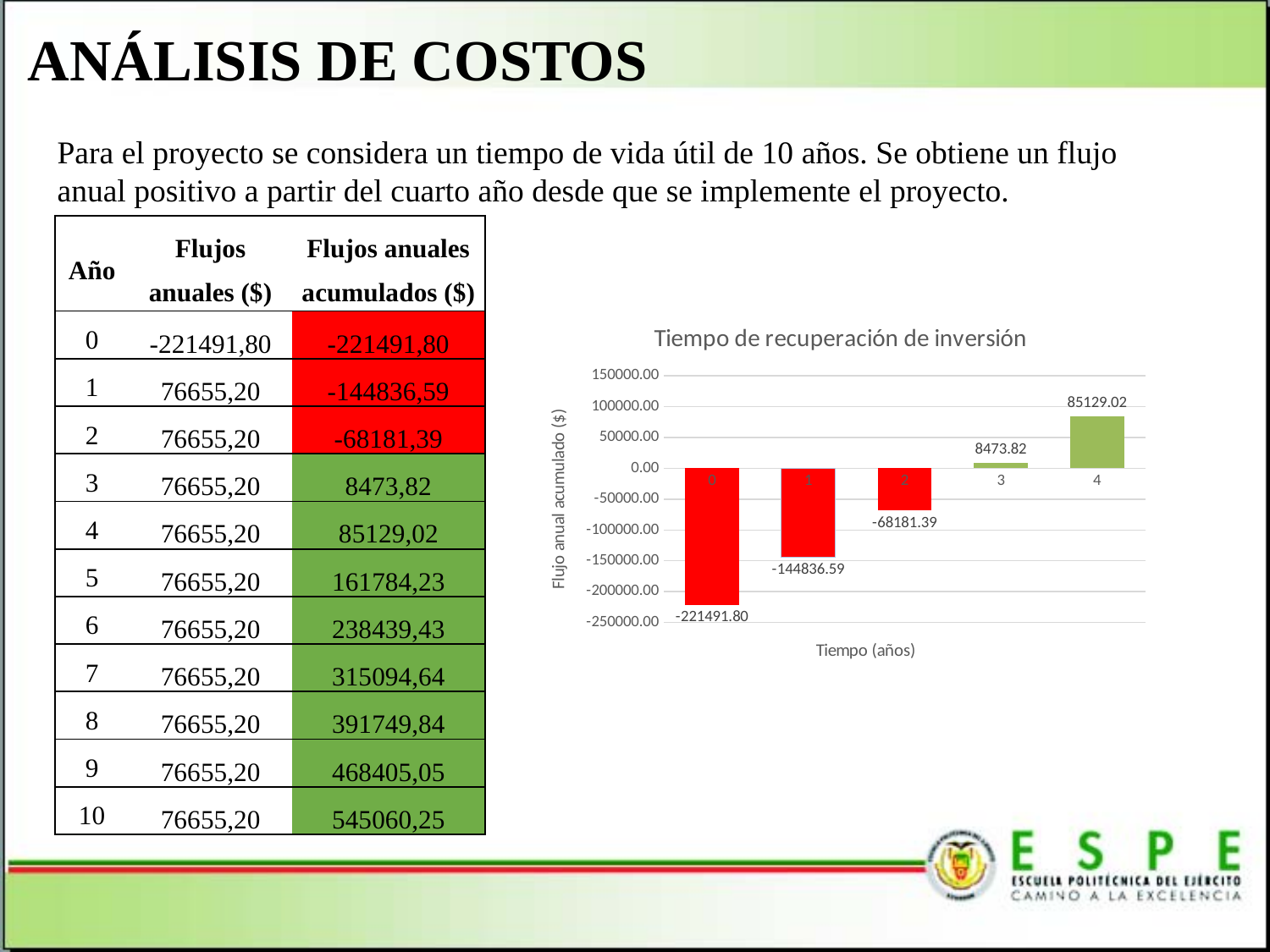
How many bars are plotted in the chart? 5 What is the value for year 2 in the chart? -68181.39 What is the value for year 4 in the chart? 85129.02 What is the difference between the values for year 4 and year 3 in the chart? 76655.20 Is the value for year 1 in the chart greater or less than -100000.00? less What kind of chart is shown on the slide? bar chart What is the value for year 0 in the chart? -221491.80 Which year has the lowest accumulated flow in the chart? 0 Which is larger in the chart, the value for year 1 or the value for year 2? year 2 Do the values in the chart rise or fall from year 0 to year 4? rise What is the value for year 3 in the chart? 8473.82 Which year has the highest accumulated flow in the chart? 4